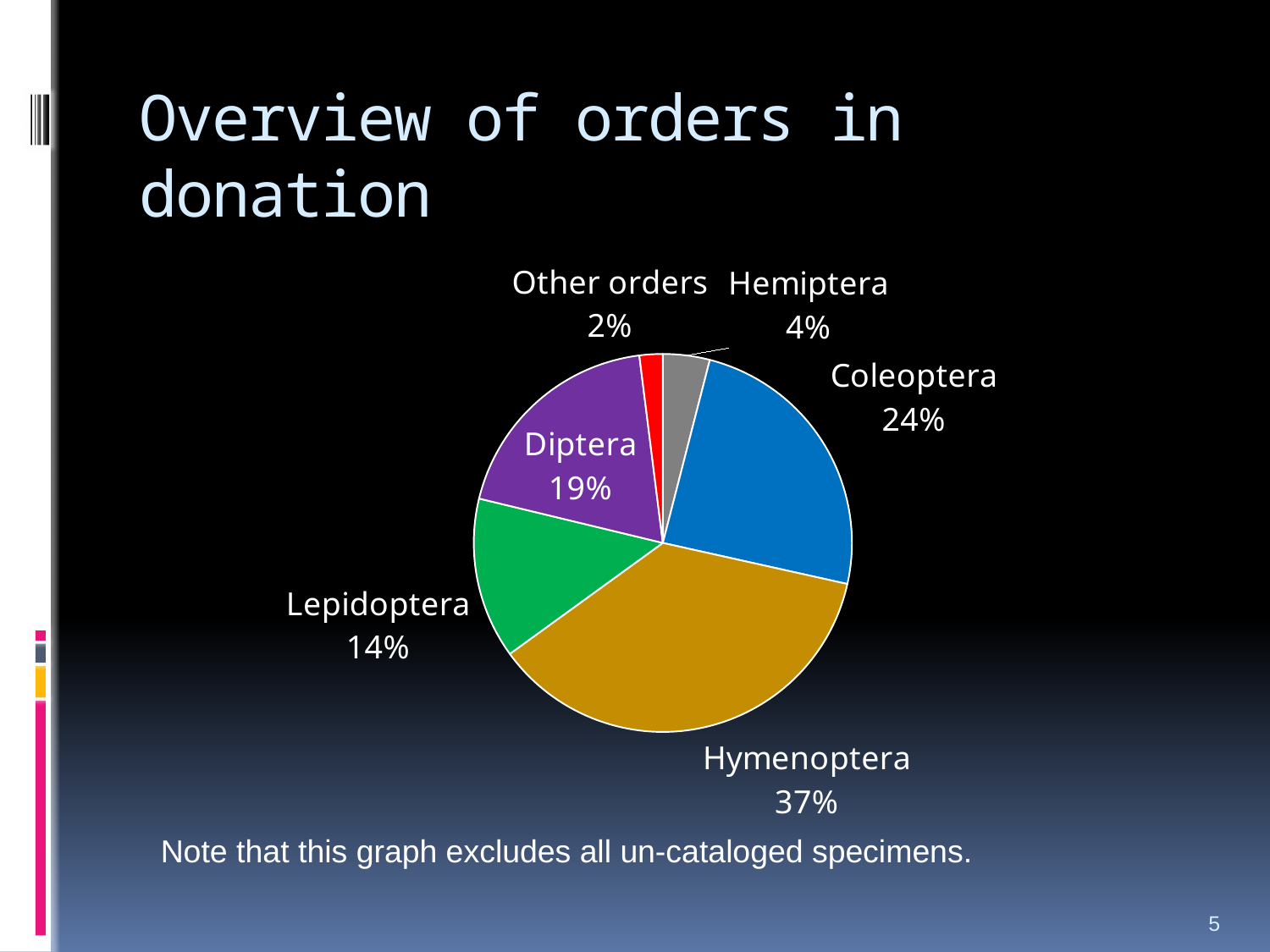
What is the difference in percentage points between Hymenoptera and Coleoptera? 13 Which is larger, the Diptera slice or the Lepidoptera slice? Diptera What percentage is shown for Hemiptera? 4% What colour is the Hymenoptera slice? gold Which order has the largest slice of the pie? Hymenoptera What percentage is shown for Lepidoptera? 14% Which slice of the pie is the smallest? Other orders How many slices does the pie chart have? 6 What percentage is shown for Diptera? 19% What share of the pie does Hymenoptera represent? 37% What percentage is shown for Coleoptera? 24% What kind of chart is shown on the slide? pie chart